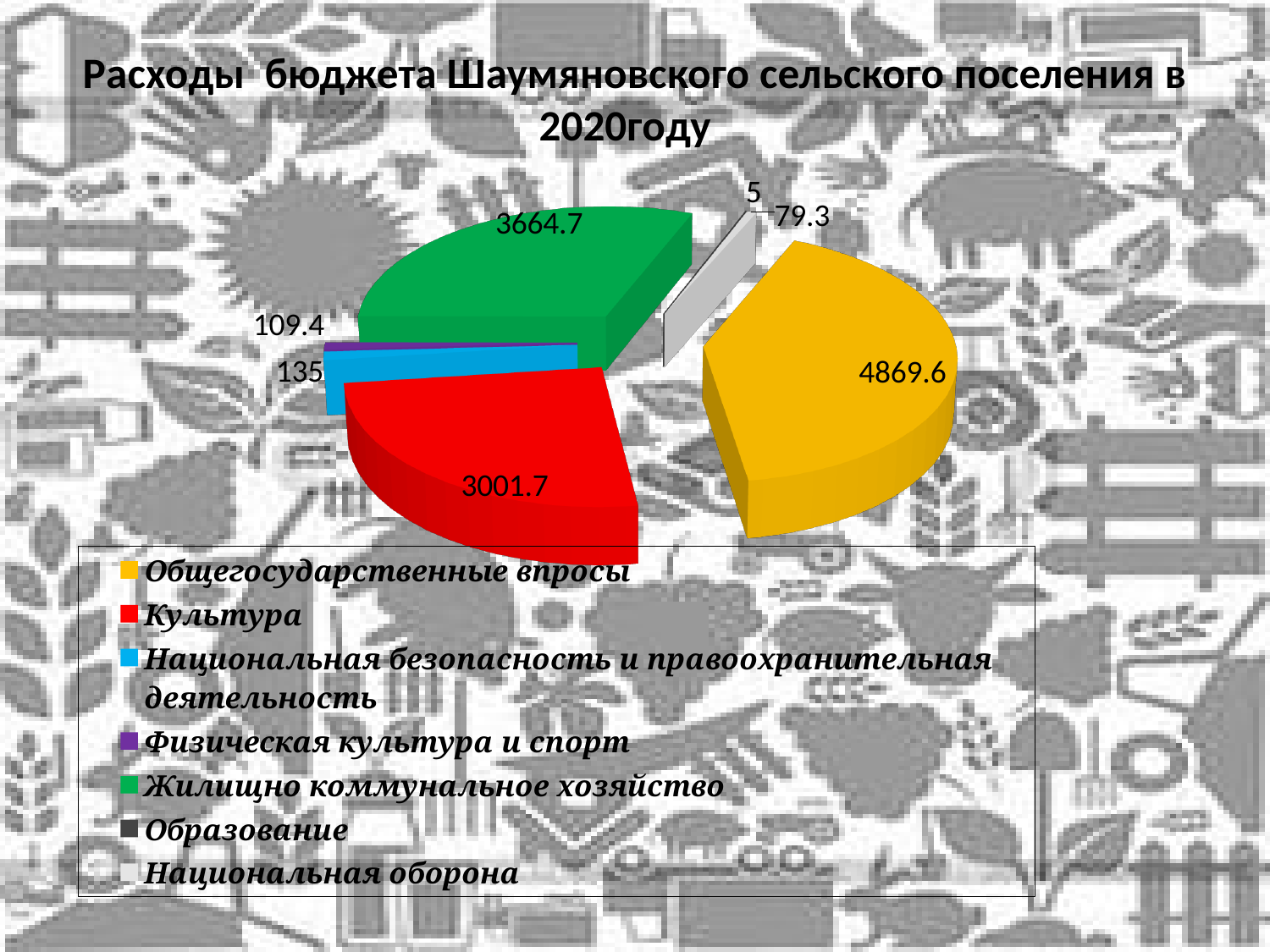
What is the value for Культура? 3001.7 How many categories does the legend list? 7 Which is larger, the value for Культура or the value for Жилищно коммунальное хозяйство? Жилищно коммунальное хозяйство What is the value for Жилищно коммунальное хозяйство? 3664.7 What kind of chart is shown on the slide? Pie chart What is the difference between the values for Жилищно коммунальное хозяйство and Культура? 663 What is the value for Национальная безопасность и правоохранительная деятельность? 135 What is the value for Физическая культура и спорт? 109.4 Which category has the largest value? Общегосударственные впросы Which category has the smallest value? Образование What is the value for Общегосударственные впросы? 4869.6 What is the value for Национальная оборона? 79.3